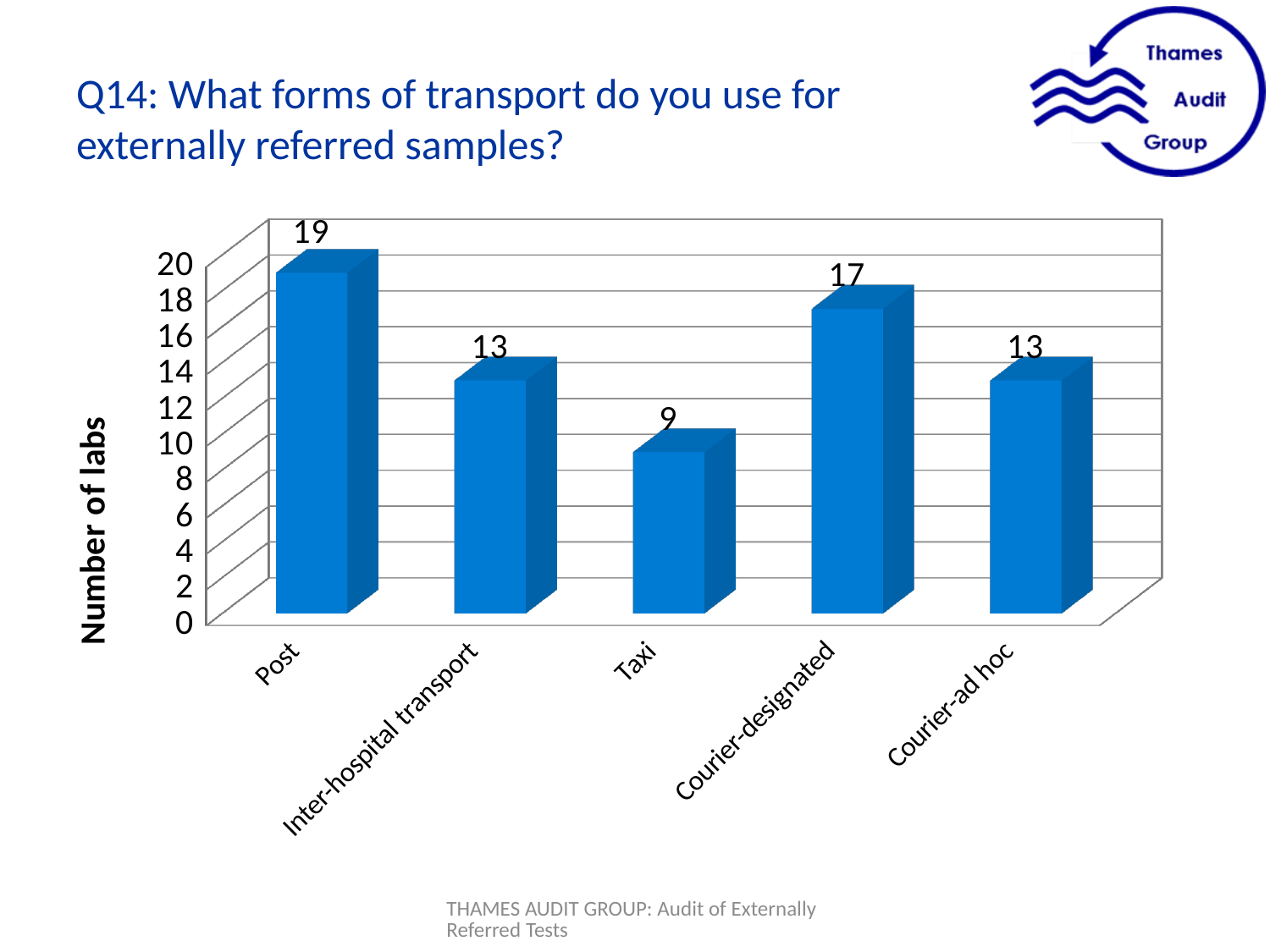
Which form of transport has the lowest number of labs? Taxi What is the value for Courier-designated? 17 Which form of transport has the highest number of labs? Post What is the label of the vertical axis? Number of labs What kind of chart is shown on the slide? Bar chart What is the value for Taxi? 9 What is the difference between the values for Courier-designated and Courier-ad hoc? 4 How many labs use Post for externally referred samples? 19 How many forms of transport are shown on the chart? 5 What is the difference between the values for Post and Taxi? 10 Which is larger, the value for Courier-designated or the value for Inter-hospital transport? Courier-designated What is the value for Inter-hospital transport? 13